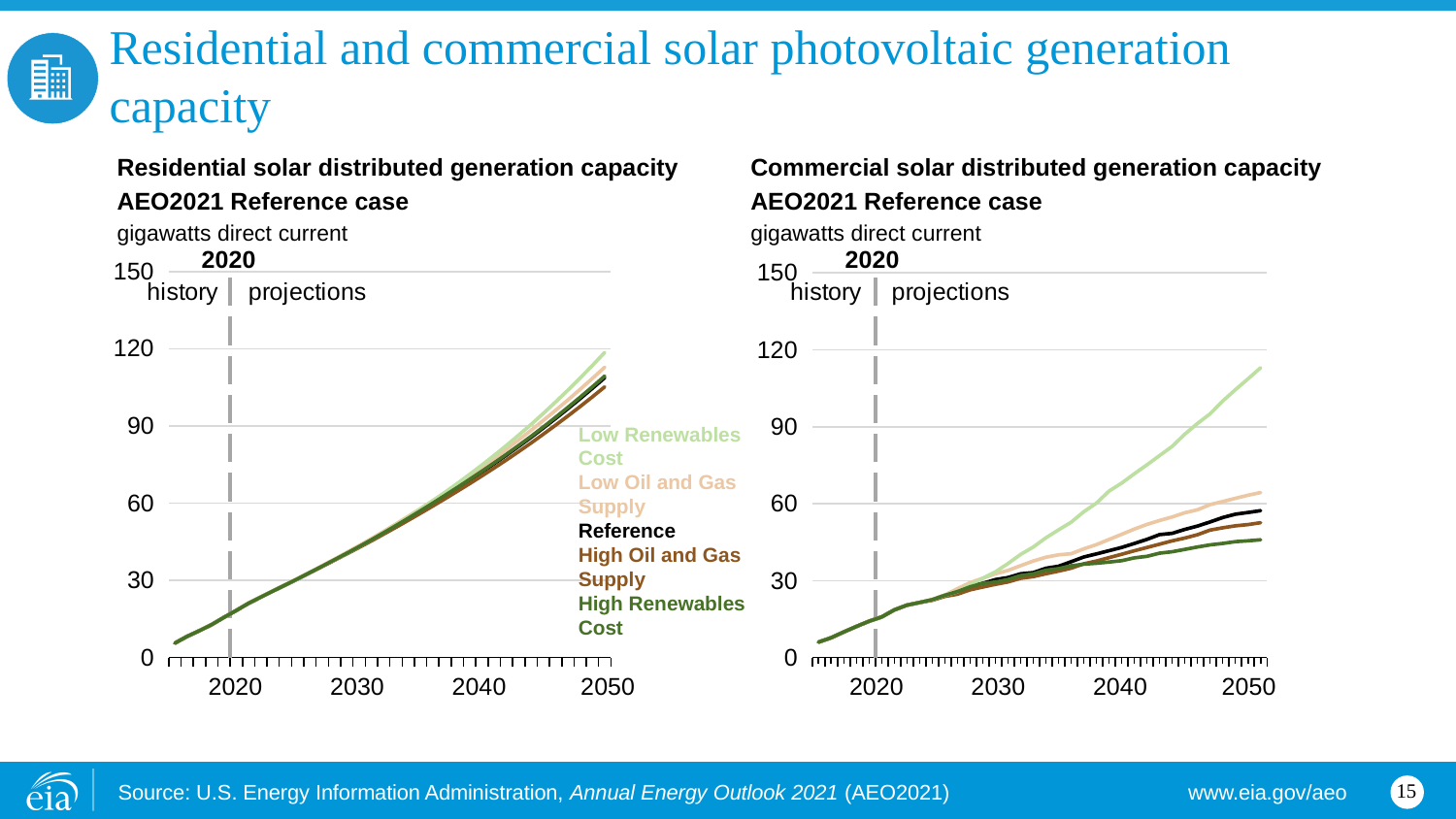
What unit is shown on the y axis of the Commercial solar distributed generation capacity chart? gigawatts direct current On the Commercial solar distributed generation capacity chart, is the High Renewables Cost value in 2050 greater or less than 60? less On the Residential solar distributed generation capacity chart, which series is highest in 2050? Low Renewables Cost What kind of chart is the Residential solar distributed generation capacity chart? line chart On the Commercial solar distributed generation capacity chart, which is larger in 2050: Reference or High Renewables Cost? Reference On the Commercial solar distributed generation capacity chart, which series is highest in 2050? Low Renewables Cost What year separates history from projections on the Residential solar distributed generation capacity chart? 2020 On the Residential solar distributed generation capacity chart, is the Low Renewables Cost value in 2050 greater or less than 90? greater How many series does the legend on the Residential solar distributed generation capacity chart list? 5 On the Commercial solar distributed generation capacity chart, which series is lowest in 2050? High Renewables Cost On the Commercial solar distributed generation capacity chart, is the Low Renewables Cost value in 2050 greater or less than 90? greater On the Residential solar distributed generation capacity chart, do the values rise or fall from 2020 to 2050? rise